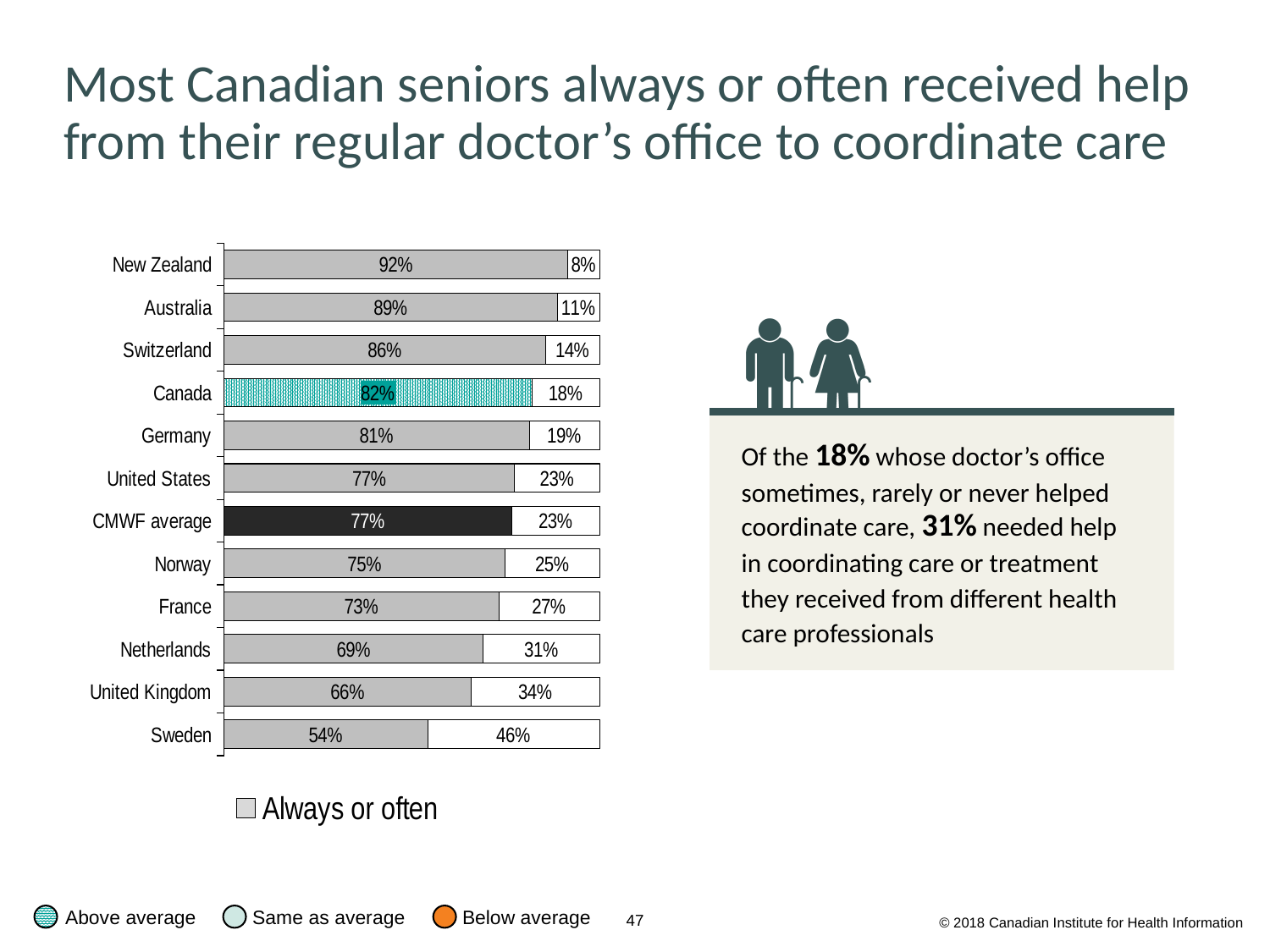
How many series does the chart legend list? 1 What type of chart is shown on the slide? Bar chart Which country has the lowest 'Always or often' percentage? Sweden Which country has the highest 'Always or often' percentage? New Zealand How many countries or categories are shown in the chart? 12 What is the CMWF average for 'Always or often'? 77% What is the value of the second (unlabelled) segment for the United Kingdom? 34% What is the 'Always or often' value for Sweden? 54% What is the legend entry shown below the chart? Always or often What is the difference in percentage points between New Zealand's and Sweden's 'Always or often' values? 38 What percentage of seniors in Canada always or often received help from their regular doctor's office to coordinate care? 82% Which has a higher 'Always or often' value, Canada or Germany? Canada